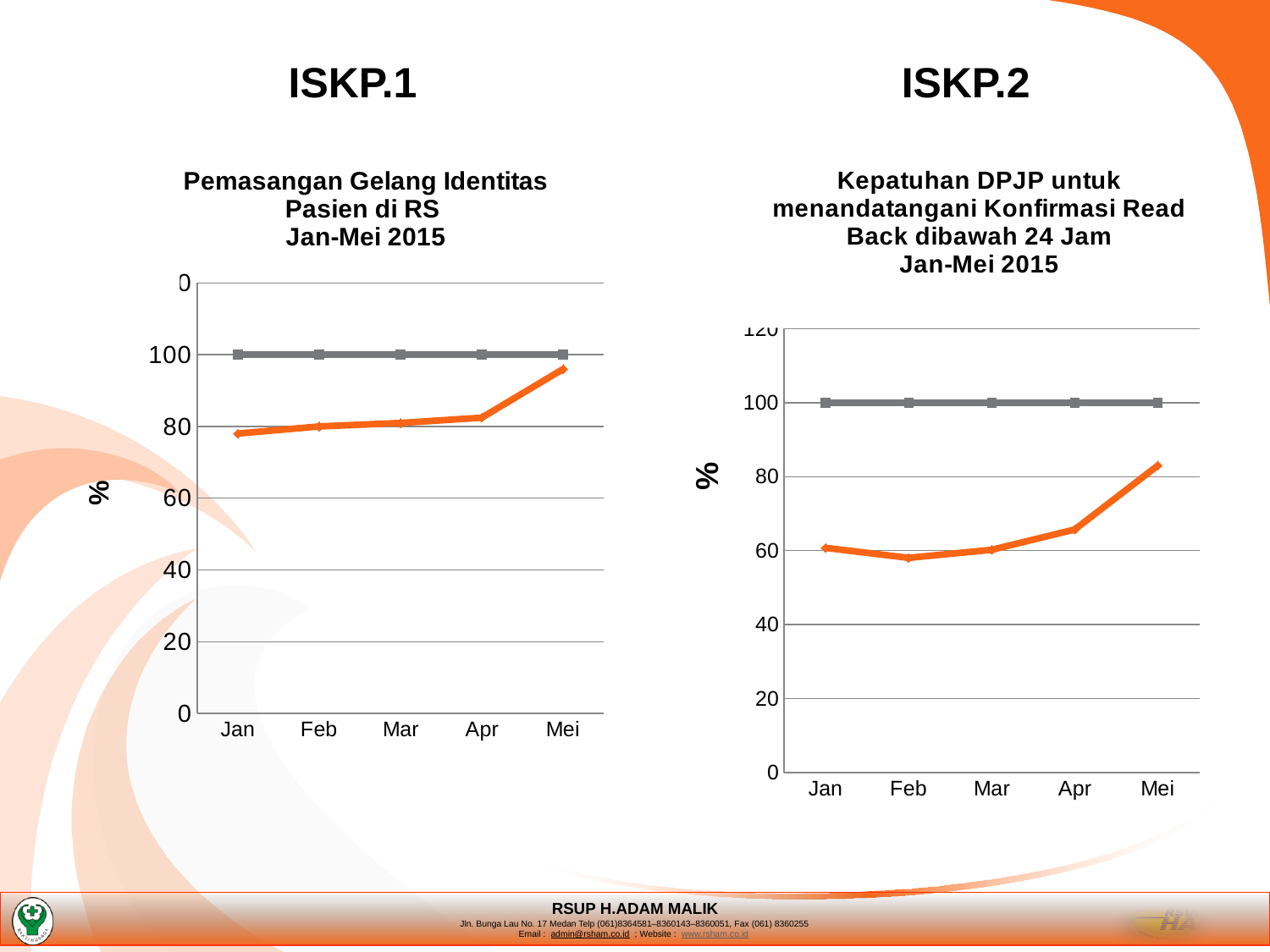
How many months are shown on the x axis of the ISKP.1 chart? 5 In the ISKP.2 chart, is the orange line value for Apr greater or less than 60? greater In the ISKP.1 chart, is the orange line value for Mei greater or less than 100? less How many months are shown on the x axis of the ISKP.2 chart? 5 What kind of chart is the ISKP.2 chart 'Kepatuhan DPJP untuk menandatangani Konfirmasi Read Back dibawah 24 Jam Jan-Mei 2015'? line chart What kind of chart is the ISKP.1 chart 'Pemasangan Gelang Identitas Pasien di RS Jan-Mei 2015'? line chart In the ISKP.1 chart, which month has the highest value on the orange line? Mei In the ISKP.2 chart, which month has the highest value on the orange line? Mei What is the label on the vertical axis of the ISKP.1 chart? % In the ISKP.1 chart, is the orange line value for Mei greater or less than 80? greater In the ISKP.2 chart, which is larger on the orange line, the value for Apr or the value for Mei? Mei